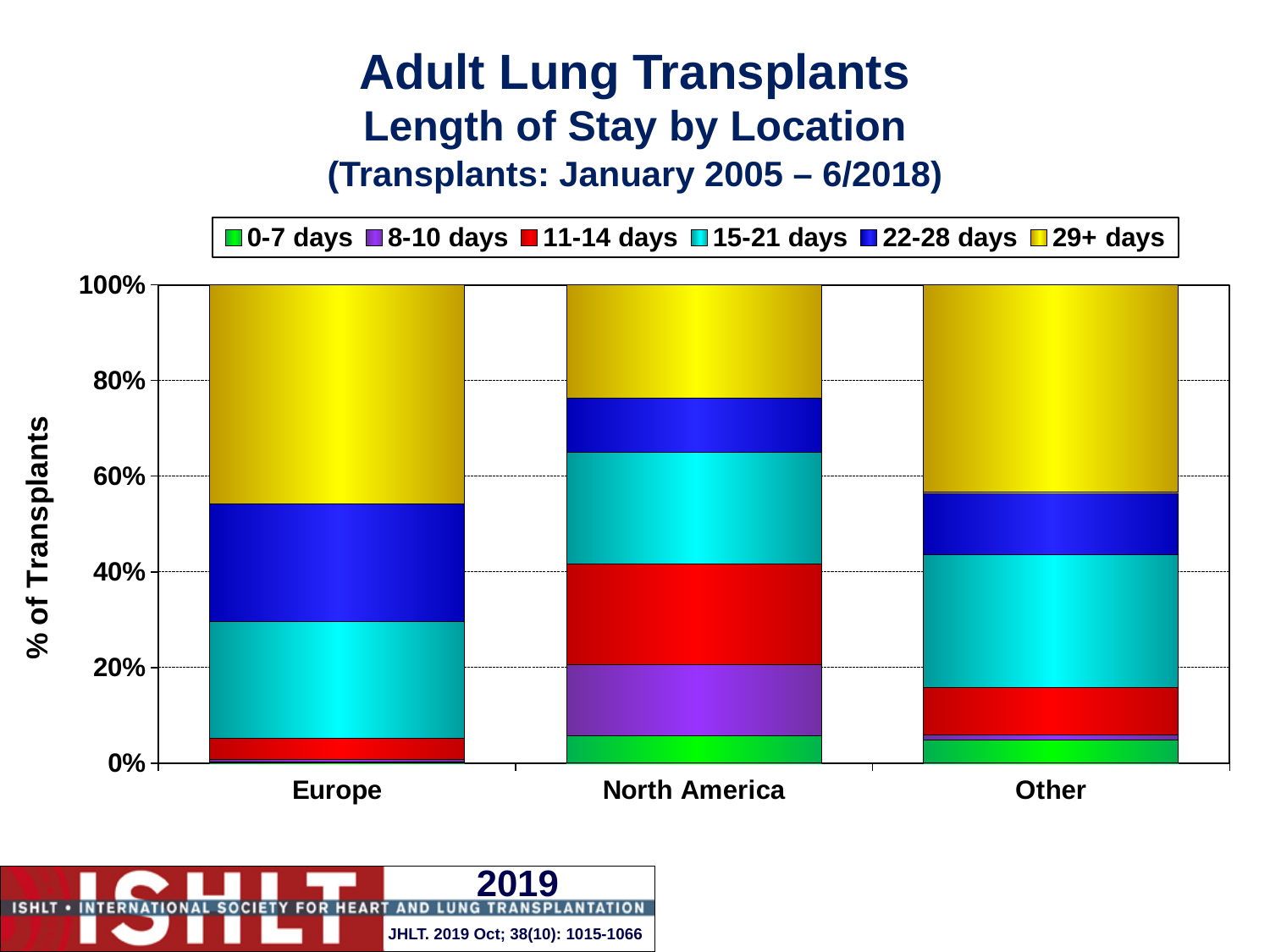
Which is larger: the 11-14 days share for North America or the 11-14 days share for Europe? North America Which location has the largest share of transplants with a length of stay of 8-10 days? North America What kind of chart is shown on the slide? Stacked bar chart What does each stacked bar total? 100% Is the share of 15-21 days stays for Other greater or less than 20%? greater What is the label of the y axis? % of Transplants How many length-of-stay categories does the legend list? 6 Which location has the largest share of transplants with a length of stay of 22-28 days? Europe Is the share of 29+ days stays for Europe greater or less than 40%? greater Which location has the smallest share of transplants with a length of stay of 29+ days? North America Which location has the largest share of transplants with a length of stay of 11-14 days? North America How many locations are shown on the x axis? 3